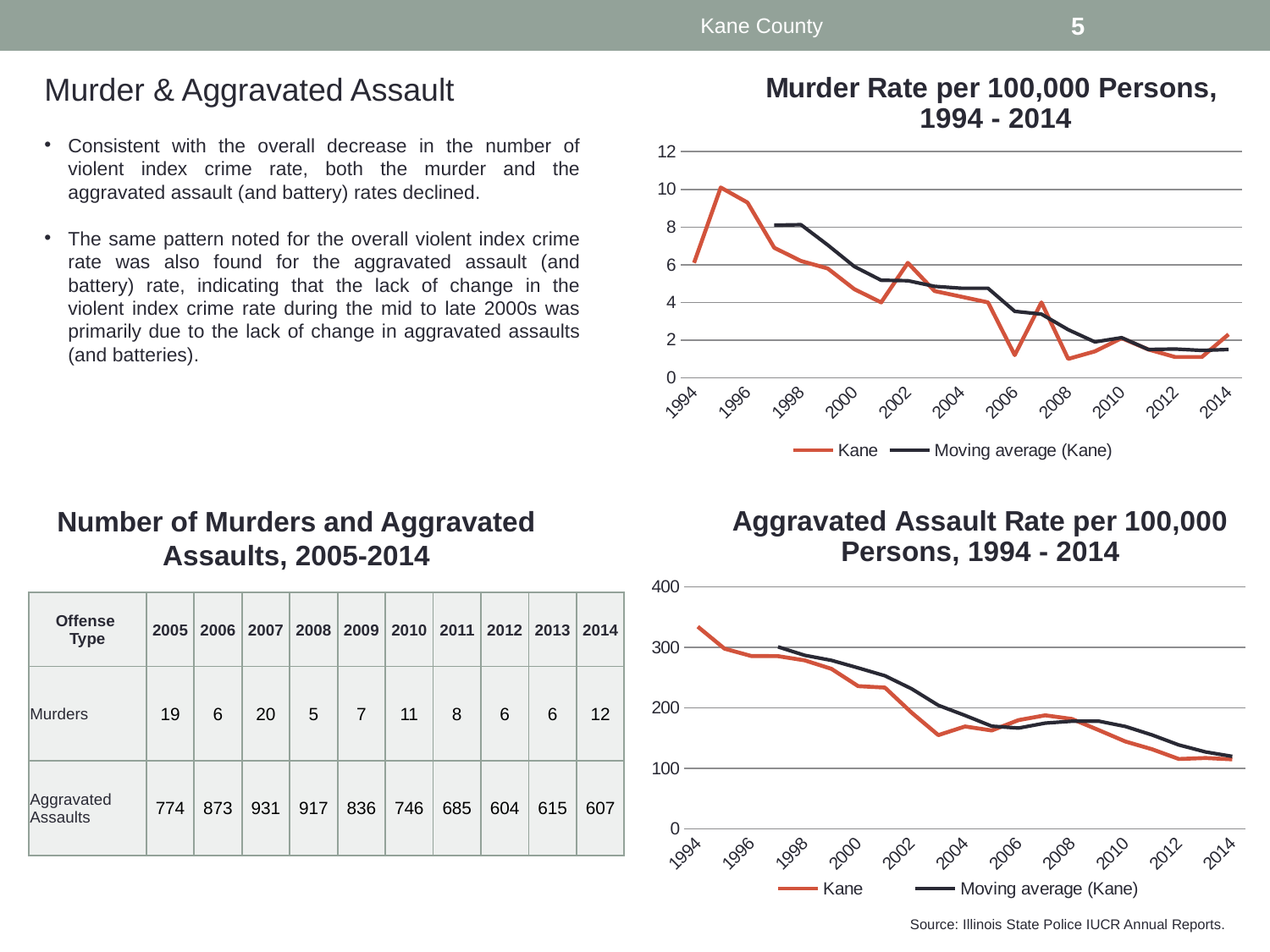
What kind of chart is the 'Murder Rate per 100,000 Persons, 1994 - 2014' chart? line chart In the 'Aggravated Assault Rate per 100,000 Persons, 1994 - 2014' chart, is the Kane value for 2014 greater or less than 200? less How many series does the legend of the 'Murder Rate per 100,000 Persons, 1994 - 2014' chart list? 2 In the 'Murder Rate per 100,000 Persons, 1994 - 2014' chart, is the Kane value for 1995 greater or less than 8? greater What colour is the 'Moving average (Kane)' line in the 'Aggravated Assault Rate per 100,000 Persons, 1994 - 2014' chart? black In the 'Murder Rate per 100,000 Persons, 1994 - 2014' chart, is the Kane value for 2006 greater or less than 2? less In the 'Murder Rate per 100,000 Persons, 1994 - 2014' chart, which year has the highest Kane murder rate? 1995 What kind of chart is the 'Aggravated Assault Rate per 100,000 Persons, 1994 - 2014' chart? line chart In the 'Aggravated Assault Rate per 100,000 Persons, 1994 - 2014' chart, which year has the highest Kane aggravated assault rate? 1994 In the 'Murder Rate per 100,000 Persons, 1994 - 2014' chart, which is larger: the Kane value for 1996 or for 2012? 1996 In the 'Murder Rate per 100,000 Persons, 1994 - 2014' chart, does the Kane murder rate generally rise or fall from 1994 to 2014? fall